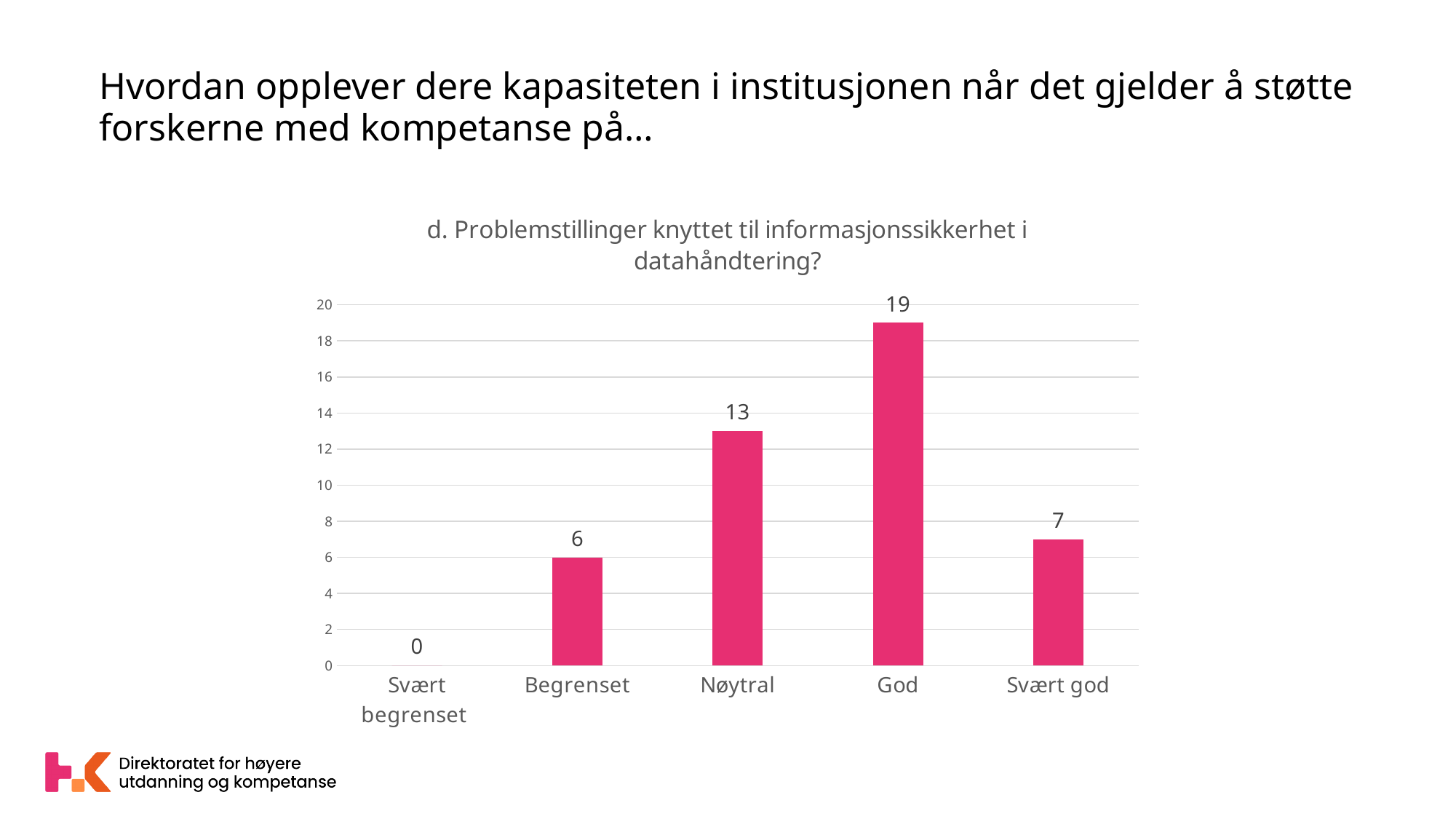
Which is larger, the value for Begrenset or the value for Svært god? Svært god How many categories are shown on the x axis? 5 Which category has the highest value? God What is the difference between the values for God and Nøytral? 6 What is the value for Begrenset? 6 What is the title of the chart? d. Problemstillinger knyttet til informasjonssikkerhet i datahåndtering? Is the value for Svært god greater or less than 10? less What is the value for Svært begrenset? 0 What is the value for Nøytral? 13 What is the value for God? 19 What kind of chart is shown on the slide? bar chart Which category has the lowest value? Svært begrenset